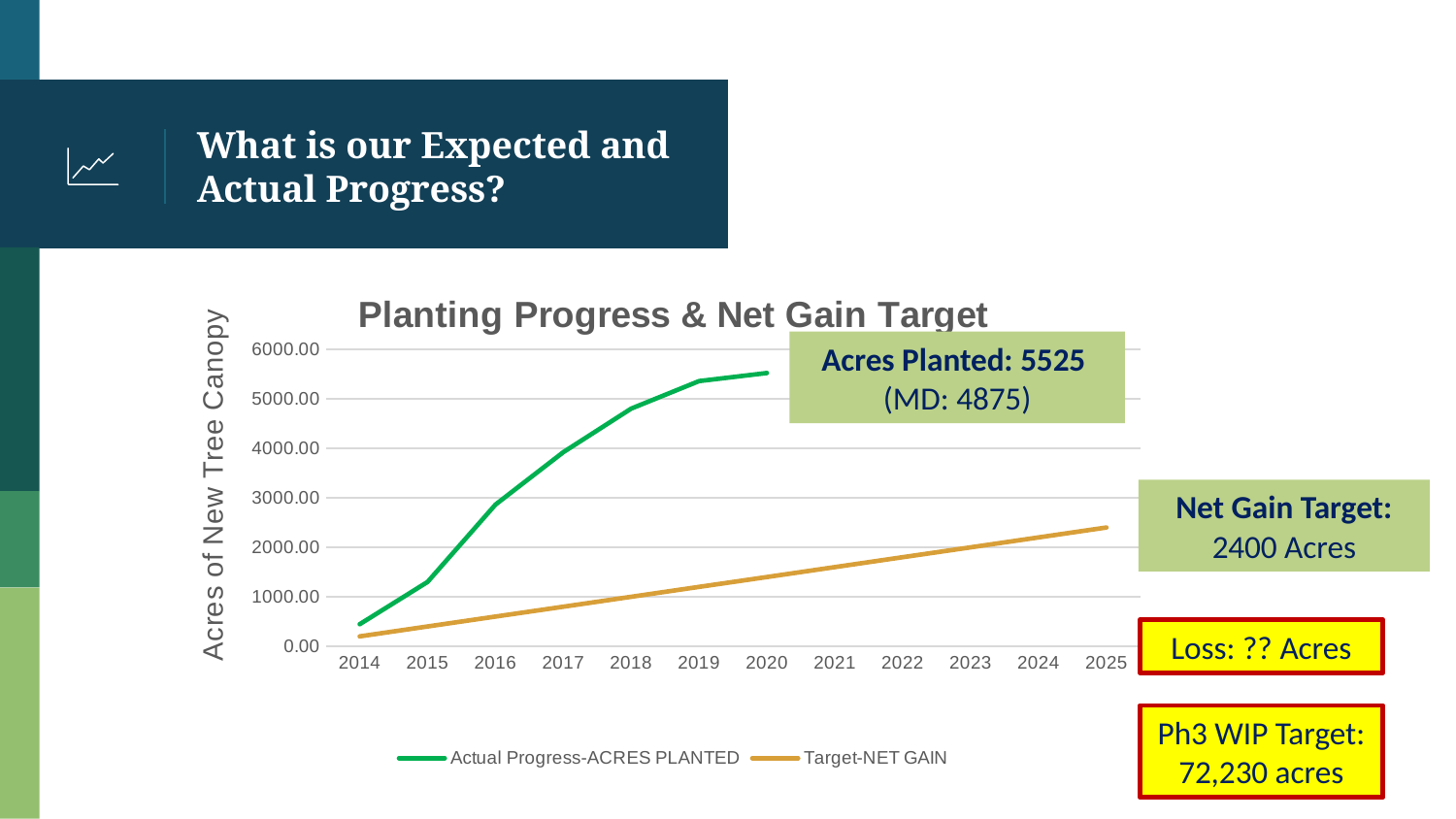
What type of chart is shown on the slide? Line chart How many series does the chart legend list? 2 According to the annotation on the chart, how many acres have been planted (Actual Progress)? 5525 How many years are labelled along the x axis of the chart? 12 What is the label on the y axis of the chart? Acres of New Tree Canopy Is the Actual Progress-ACRES PLANTED value for 2018 greater or less than 4000? greater What is the title of the chart? Planting Progress & Net Gain Target Is the Target-NET GAIN value for 2020 greater or less than 1000? greater Does the Actual Progress-ACRES PLANTED line rise or fall from 2014 to 2020? Rise According to the annotation on the chart, what is the Net Gain Target in acres? 2400 Acres In 2019, which series has the larger value: Actual Progress-ACRES PLANTED or Target-NET GAIN? Actual Progress-ACRES PLANTED Is the Actual Progress-ACRES PLANTED value for 2015 greater or less than 2000? less